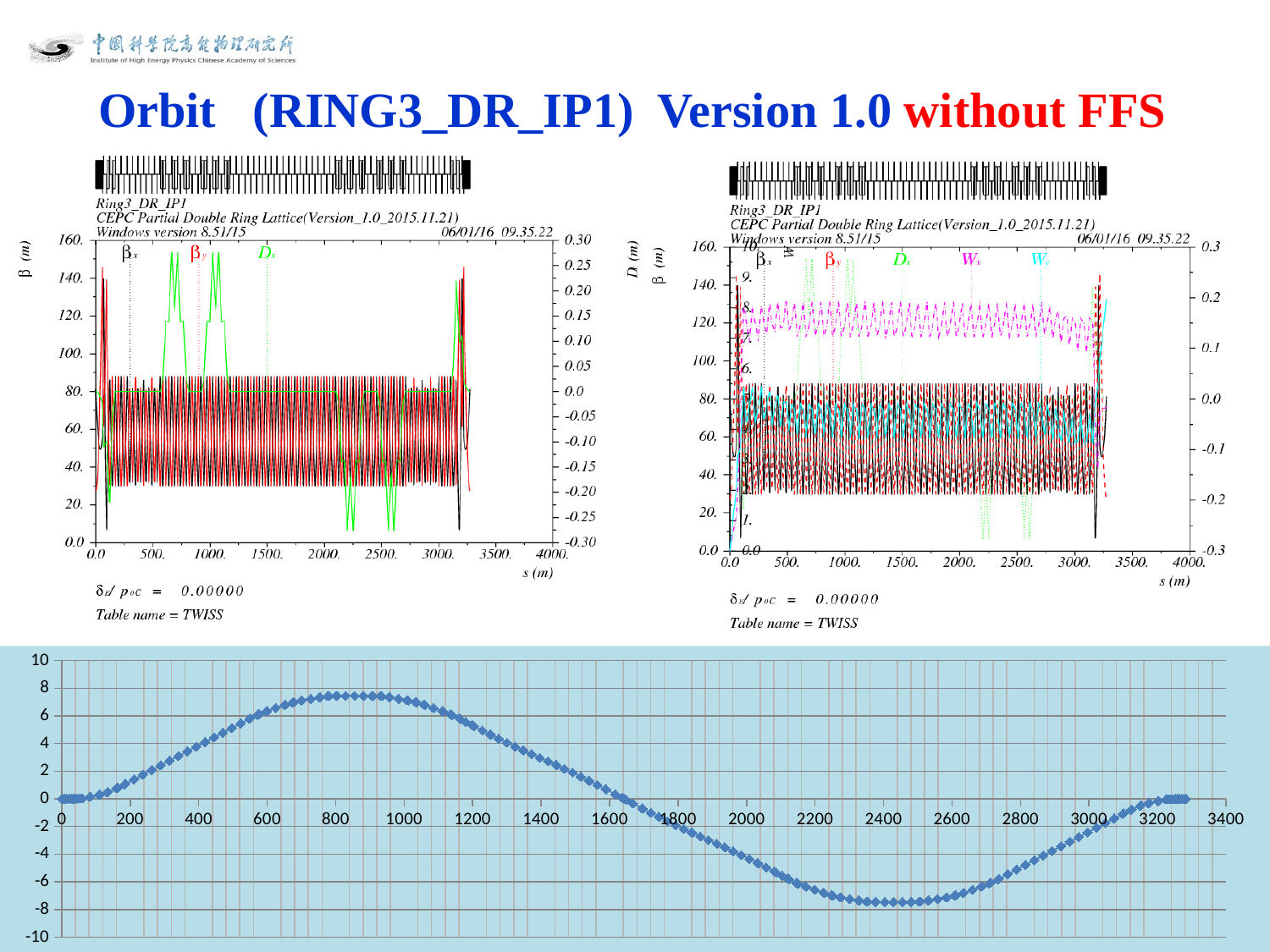
How many series does the legend of the top-left chart list? 3 In the bottom chart, do the values rise or fall as x goes from 0 to 800? rise In the bottom chart, is the value at x = 2400 greater or less than -6? less In the bottom chart, do the values rise or fall as x goes from 1000 to 2400? fall In the bottom chart, which has the larger value: x = 800 or x = 2400? x = 800 What is the label of the x axis on the top-left chart? s (m) In the bottom chart, is the value at x = 2800 greater or less than -4? less What is the largest tick value shown on the x axis of the bottom chart? 3400 What is the highest tick value on the left y axis of the top-left chart? 160. In the bottom chart, is the value at x = 400 greater or less than 2? greater How many series does the legend of the top-right chart list? 5